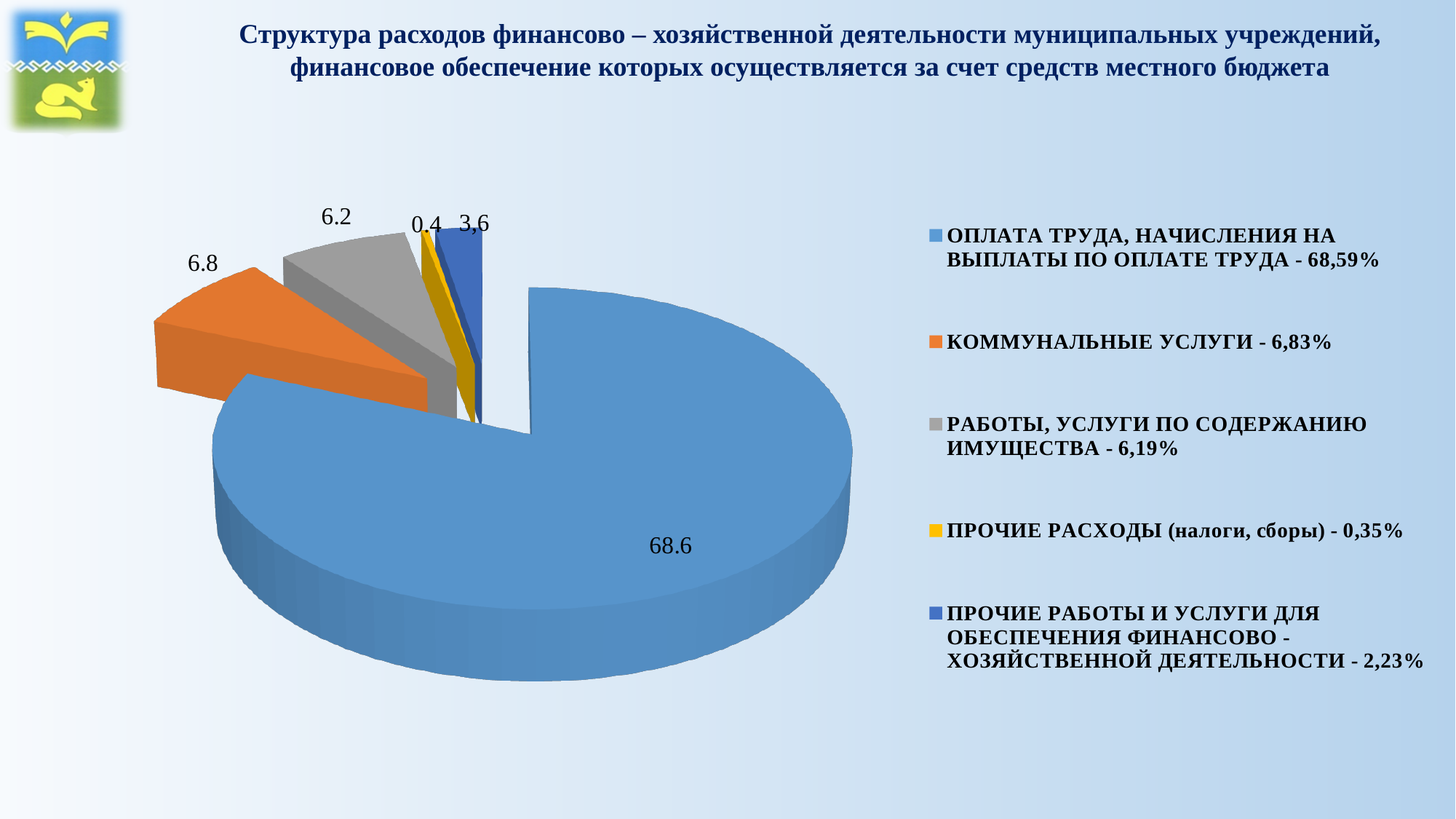
How many slices does the pie chart have? 5 What is the difference between the data labels for КОММУНАЛЬНЫЕ УСЛУГИ and РАБОТЫ, УСЛУГИ ПО СОДЕРЖАНИЮ ИМУЩЕСТВА? 0.6 Which category has the largest slice of the pie? ОПЛАТА ТРУДА, НАЧИСЛЕНИЯ НА ВЫПЛАТЫ ПО ОПЛАТЕ ТРУДА What is the data label on the pie slice for ОПЛАТА ТРУДА, НАЧИСЛЕНИЯ НА ВЫПЛАТЫ ПО ОПЛАТЕ ТРУДА? 68.6 What is the data label on the pie slice for КОММУНАЛЬНЫЕ УСЛУГИ? 6.8 Which slice is larger: КОММУНАЛЬНЫЕ УСЛУГИ or РАБОТЫ, УСЛУГИ ПО СОДЕРЖАНИЮ ИМУЩЕСТВА? КОММУНАЛЬНЫЕ УСЛУГИ What is the data label on the pie slice for РАБОТЫ, УСЛУГИ ПО СОДЕРЖАНИЮ ИМУЩЕСТВА? 6.2 What percentage does the legend give for КОММУНАЛЬНЫЕ УСЛУГИ? 6,83% Which category has the smallest slice of the pie? ПРОЧИЕ РАСХОДЫ (налоги, сборы) What is the data label on the pie slice for ПРОЧИЕ РАБОТЫ И УСЛУГИ ДЛЯ ОБЕСПЕЧЕНИЯ ФИНАНСОВО - ХОЗЯЙСТВЕННОЙ ДЕЯТЕЛЬНОСТИ? 3,6 What is the data label on the pie slice for ПРОЧИЕ РАСХОДЫ (налоги, сборы)? 0.4 What kind of chart is shown on the slide? Pie chart